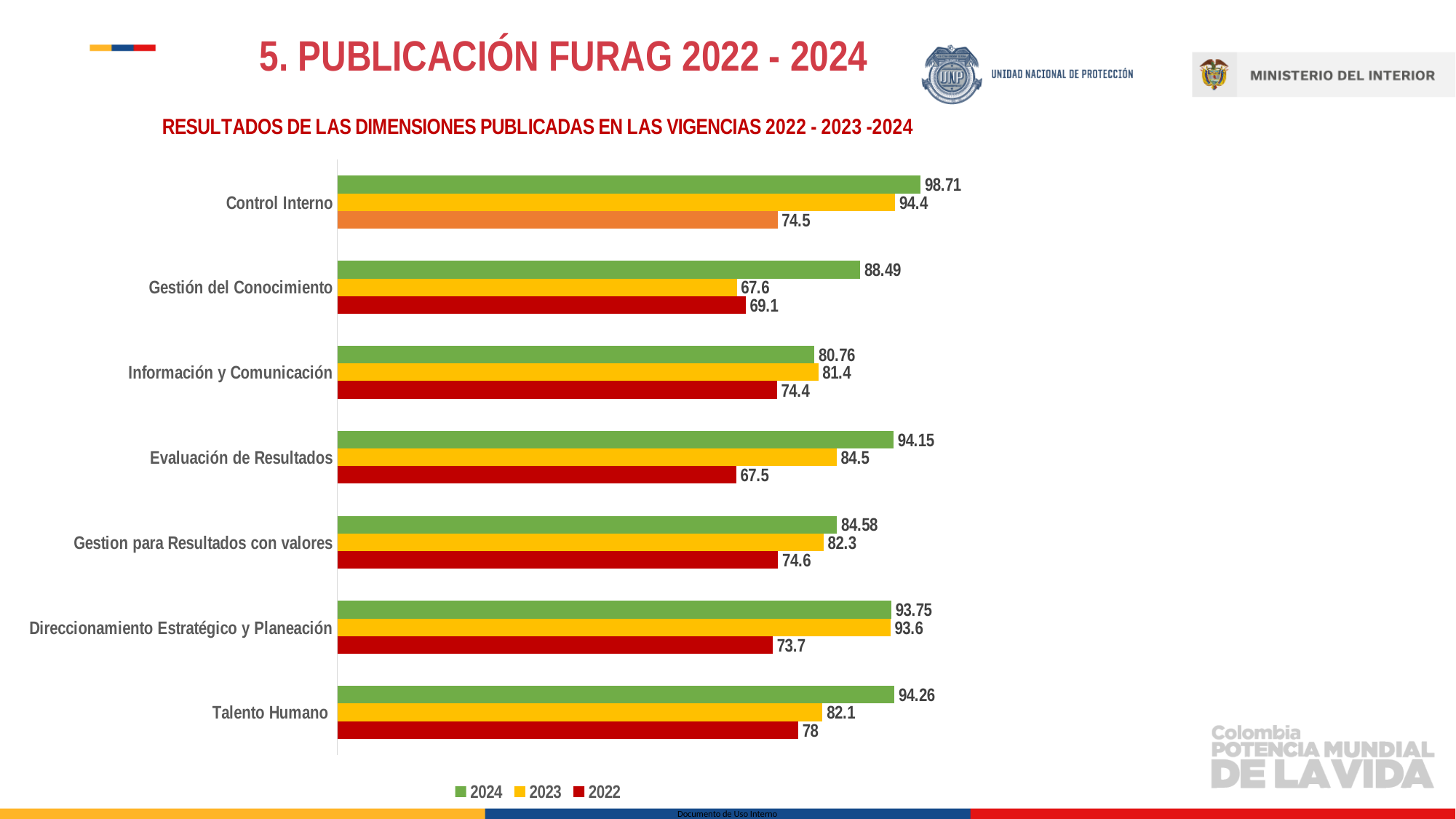
Which dimension has the highest 2024 value? Control Interno Which dimension has the lowest 2023 value? Gestión del Conocimiento What kind of chart is shown on the slide? Bar chart What is the 2023 value for Evaluación de Resultados? 84.5 What is the difference between the 2023 and 2022 values for Control Interno? 19.9 What is the 2024 value for Control Interno? 98.71 For Información y Comunicación, which year has the larger value, 2023 or 2024? 2023 What is the difference between the 2024 and 2022 values for Evaluación de Resultados? 26.65 What is the 2022 value for Talento Humano? 78 How many dimensions (categories) are shown in the chart? 7 How many series does the legend list? 3 Which dimension has the lowest 2022 value? Evaluación de Resultados